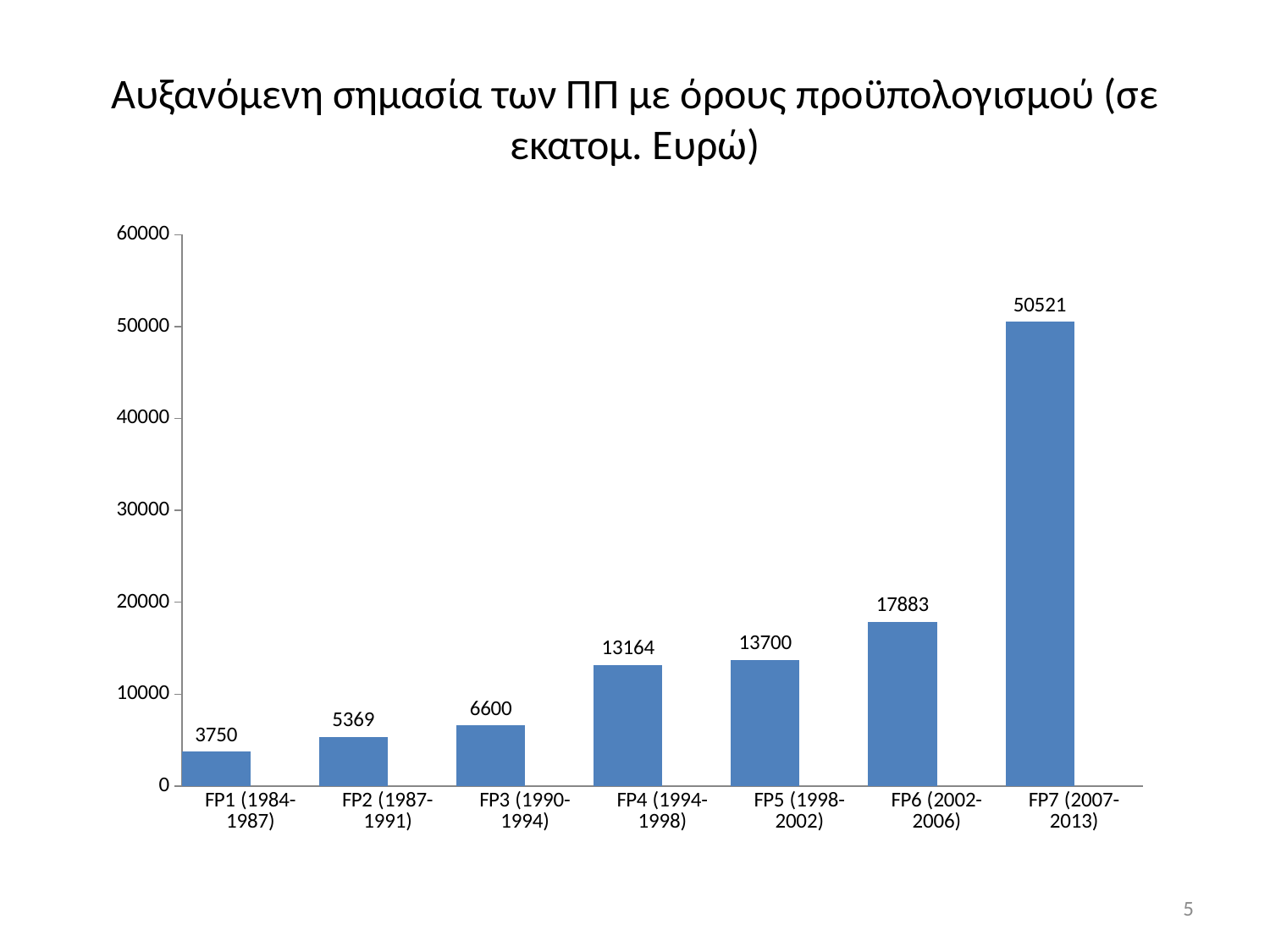
What kind of chart is shown on the slide? bar chart Do the values rise or fall from FP1 to FP7 along the x axis? rise What is the value for FP4 (1994-1998)? 13164 How many framework programmes are shown on the x axis? 7 Which is larger, the value for FP5 (1998-2002) or FP4 (1994-1998)? FP5 (1998-2002) What is the difference between the values for FP3 (1990-1994) and FP2 (1987-1991)? 1231 What is the difference between the values for FP7 (2007-2013) and FP6 (2002-2006)? 32638 Which framework programme has the highest value? FP7 (2007-2013) Is the value for FP6 (2002-2006) greater or less than 20000? less What is the value for FP1 (1984-1987)? 3750 What is the value for FP7 (2007-2013)? 50521 Which framework programme has the lowest value? FP1 (1984-1987)